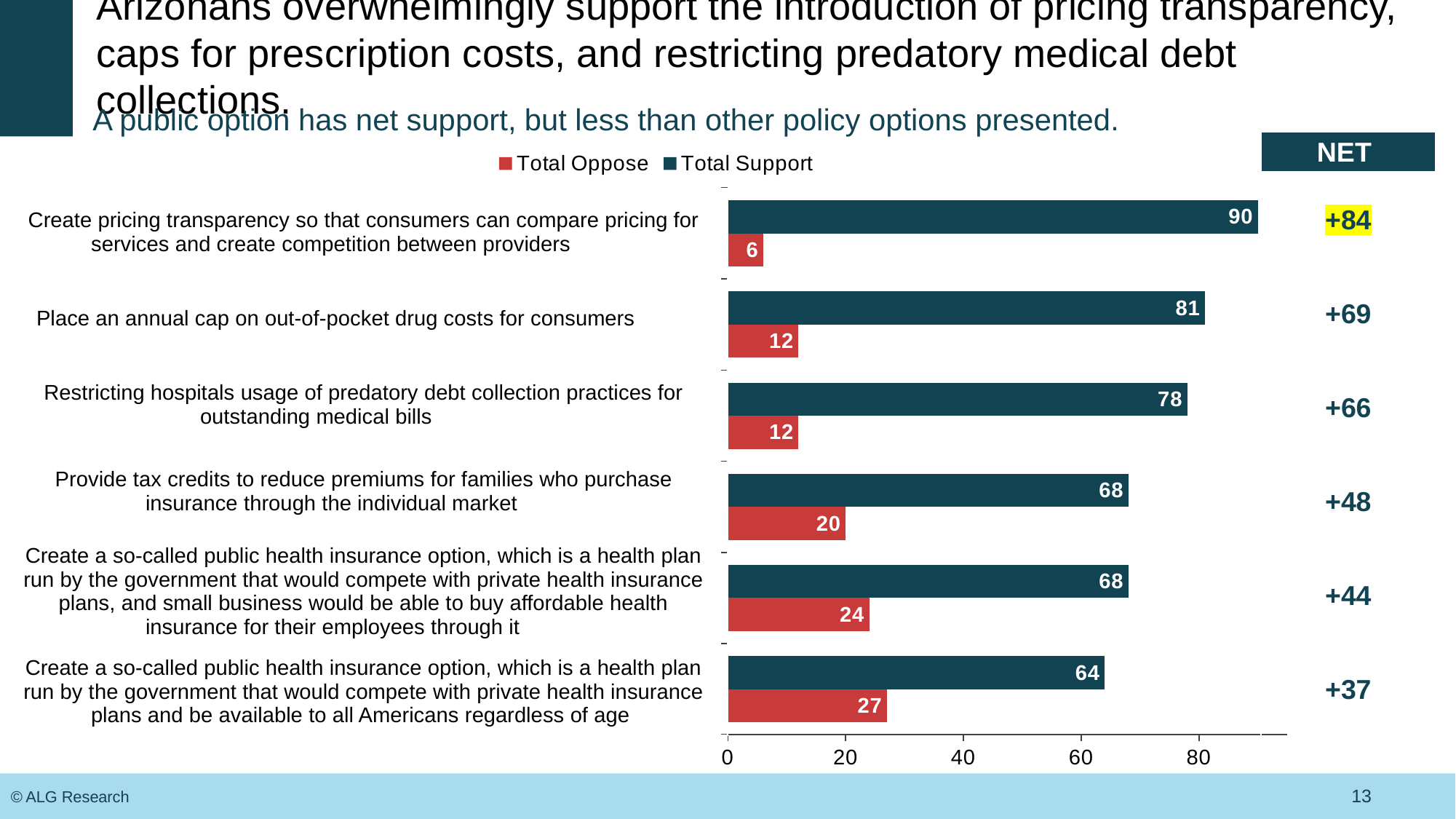
Which policy has the highest Total Support value? Create pricing transparency so that consumers can compare pricing for services and create competition between providers What kind of chart is shown on the slide? Bar chart Which policy has the lowest Total Oppose value? Create pricing transparency so that consumers can compare pricing for services and create competition between providers What is the Total Oppose value for the public health insurance option available to all Americans regardless of age? 27 How many series does the legend list? 2 How many policy options are shown in the chart? 6 What is the Total Oppose value for "Create pricing transparency so that consumers can compare pricing for services and create competition between providers"? 6 What is the NET value shown for "Provide tax credits to reduce premiums for families who purchase insurance through the individual market"? +48 Which is larger: the Total Oppose value for the tax credits policy or the Total Oppose value for the annual cap on out-of-pocket drug costs? Total Oppose for the tax credits policy Is the Total Support value for the public health insurance option available to all Americans regardless of age greater or less than 80? less What is the difference between Total Support and Total Oppose for "Restricting hospitals usage of predatory debt collection practices for outstanding medical bills"? 66 What is the Total Support value for "Place an annual cap on out-of-pocket drug costs for consumers"? 81